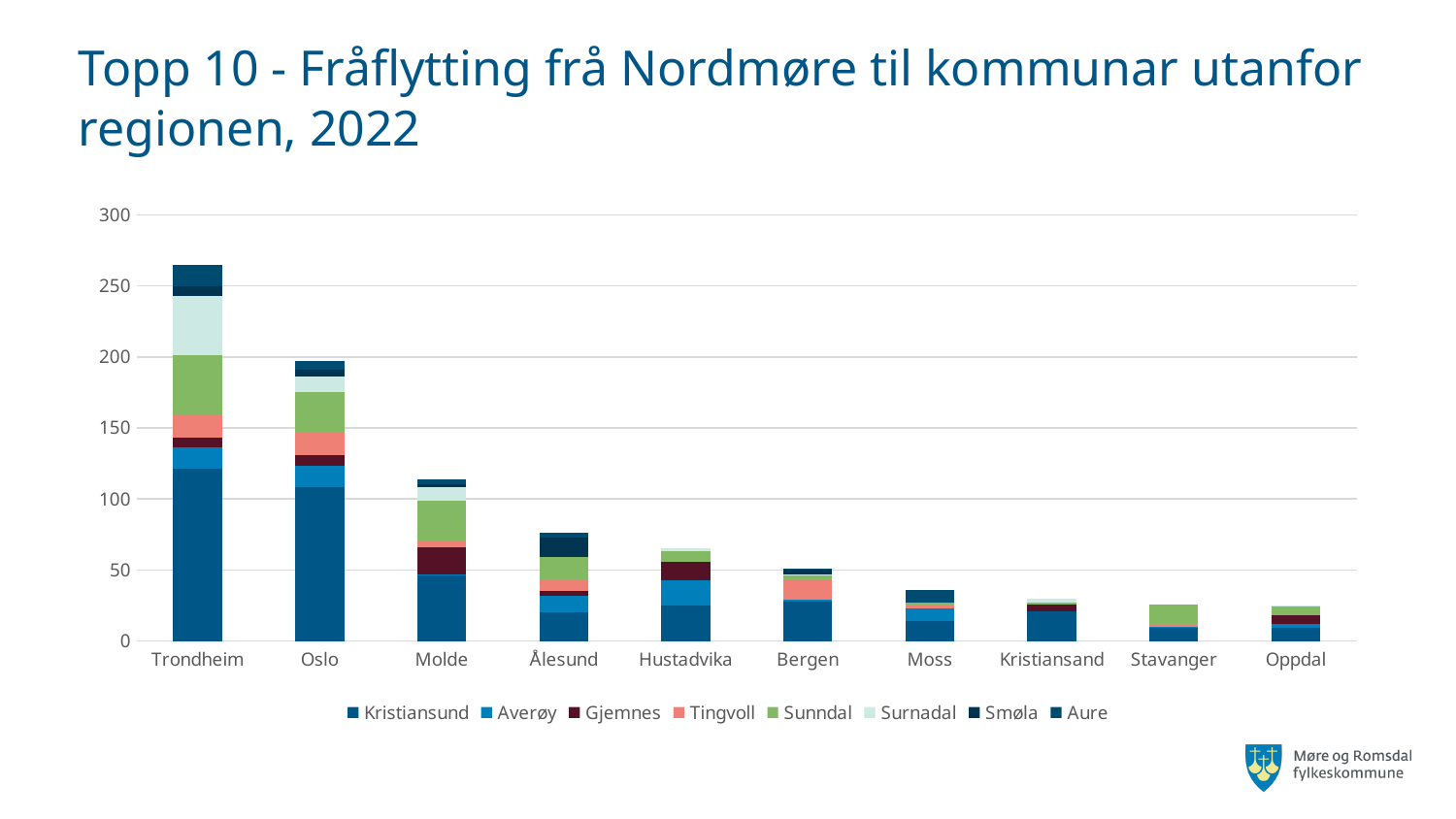
How many series does the legend list? 8 Which has the larger total bar, Molde or Ålesund? Molde What kind of chart is shown on the slide? Stacked bar chart Is the total for Moss greater or less than 50? less Is the total for Ålesund greater or less than 100? less How many destination municipalities are shown along the x axis? 10 Do the total bar heights generally rise or fall from left to right along the x axis? Fall Is the total for Trondheim greater or less than 250? greater Which destination has the highest total bar? Trondheim Which series is listed first in the legend? Kristiansund Which has the larger total bar, Trondheim or Oslo? Trondheim